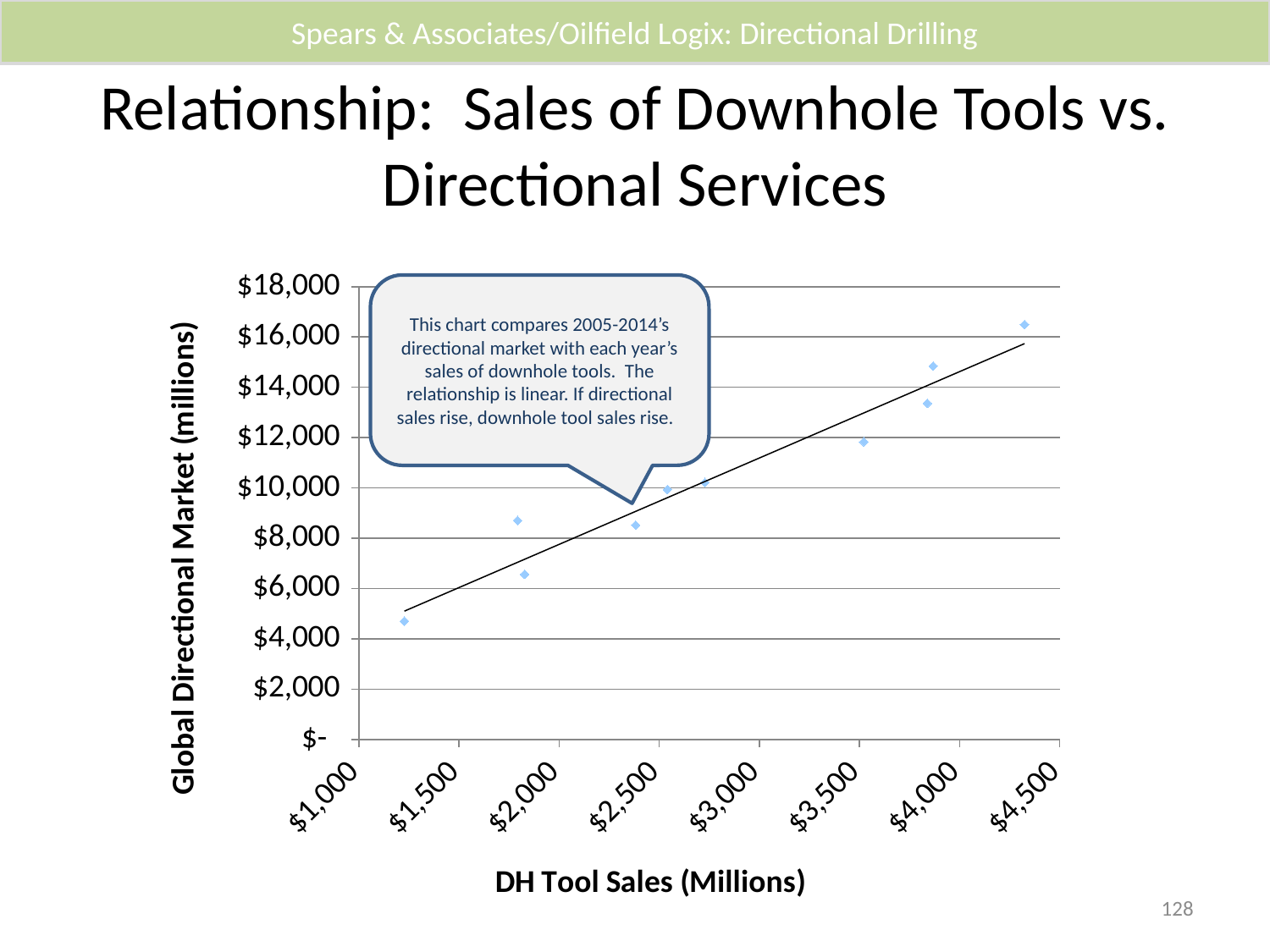
What is the title of the chart's x axis? DH Tool Sales (Millions) What is the title of the chart's y axis? Global Directional Market (millions) As DH Tool Sales increase along the x axis, does the Global Directional Market generally rise or fall? rise What kind of chart is shown on the slide? scatter chart Is the Global Directional Market value for the point near $3,500 in DH Tool Sales greater or less than $10,000? greater Is the Global Directional Market value for the point with the lowest DH Tool Sales greater or less than $6,000? less How many data points are plotted on the chart? 10 Which point has the higher Global Directional Market value: the one with the highest DH Tool Sales or the one with the lowest DH Tool Sales? the one with the highest DH Tool Sales Is the Global Directional Market value for the point with the highest DH Tool Sales greater or less than $16,000? greater What is the highest value shown on the y axis? $18,000